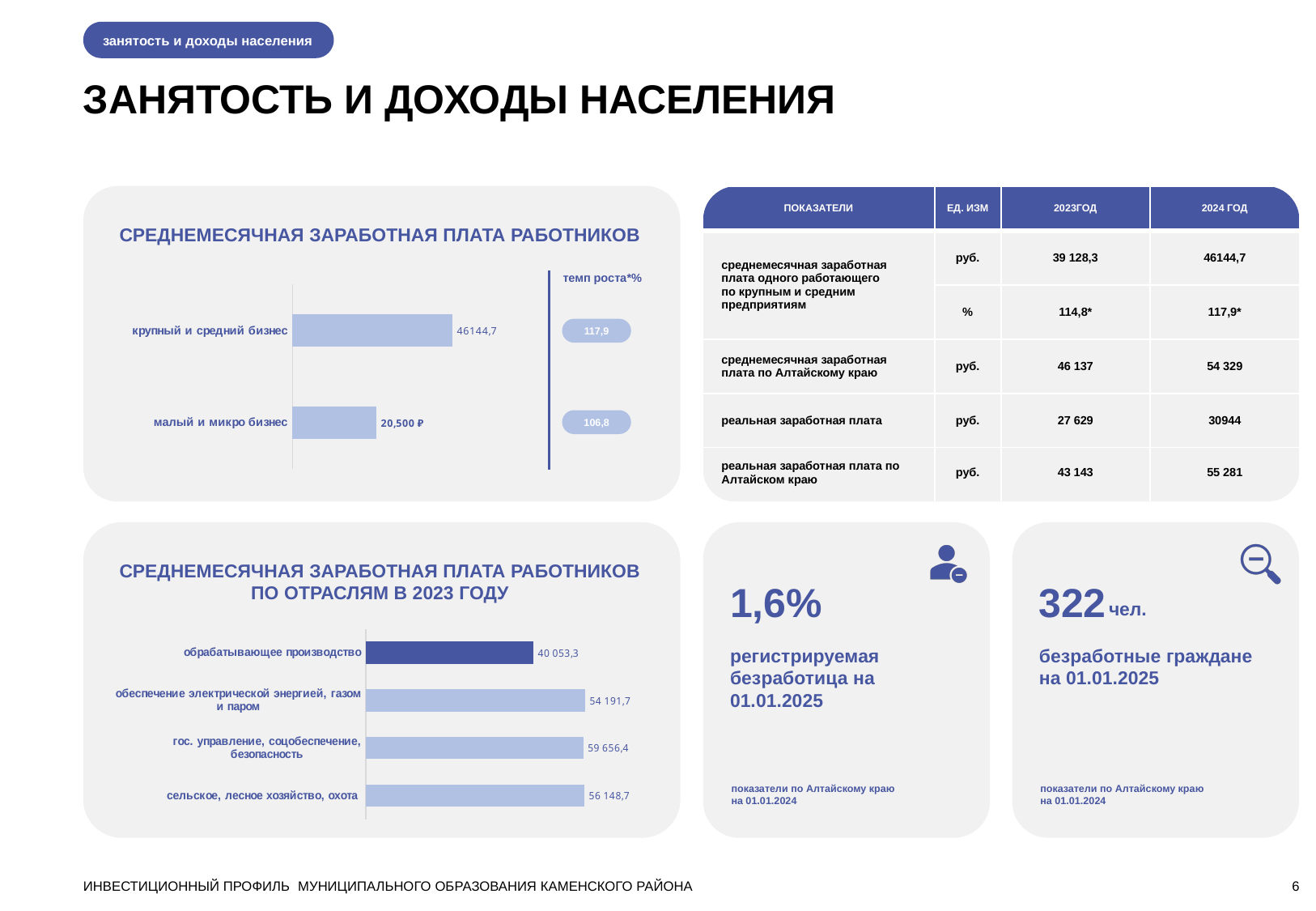
In the chart 'СРЕДНЕМЕСЯЧНАЯ ЗАРАБОТНАЯ ПЛАТА РАБОТНИКОВ' (top left), how many categories are plotted? 2 In the chart 'СРЕДНЕМЕСЯЧНАЯ ЗАРАБОТНАЯ ПЛАТА РАБОТНИКОВ ПО ОТРАСЛЯМ В 2023 ГОДУ' (bottom left), what is the value for 'обрабатывающее производство'? 40 053,3 In the chart 'СРЕДНЕМЕСЯЧНАЯ ЗАРАБОТНАЯ ПЛАТА РАБОТНИКОВ' (top left), what is the 'темп роста*%' shown for 'малый и микро бизнес'? 106,8 In the chart 'СРЕДНЕМЕСЯЧНАЯ ЗАРАБОТНАЯ ПЛАТА РАБОТНИКОВ' (top left), what is the value for 'крупный и средний бизнес'? 46144,7 In the chart 'СРЕДНЕМЕСЯЧНАЯ ЗАРАБОТНАЯ ПЛАТА РАБОТНИКОВ ПО ОТРАСЛЯМ В 2023 ГОДУ' (bottom left), which category has the highest value? гос. управление, соцобеспечение, безопасность In the chart 'СРЕДНЕМЕСЯЧНАЯ ЗАРАБОТНАЯ ПЛАТА РАБОТНИКОВ ПО ОТРАСЛЯМ В 2023 ГОДУ' (bottom left), which category has the lowest value? обрабатывающее производство In the chart 'СРЕДНЕМЕСЯЧНАЯ ЗАРАБОТНАЯ ПЛАТА РАБОТНИКОВ ПО ОТРАСЛЯМ В 2023 ГОДУ' (bottom left), which is larger: 'обеспечение электрической энергией, газом и паром' or 'сельское, лесное хозяйство, охота'? сельское, лесное хозяйство, охота In the chart 'СРЕДНЕМЕСЯЧНАЯ ЗАРАБОТНАЯ ПЛАТА РАБОТНИКОВ' (top left), what is the value for 'малый и микро бизнес'? 20,500 ₽ In the chart 'СРЕДНЕМЕСЯЧНАЯ ЗАРАБОТНАЯ ПЛАТА РАБОТНИКОВ' (top left), which category has the higher value? крупный и средний бизнес In the chart 'СРЕДНЕМЕСЯЧНАЯ ЗАРАБОТНАЯ ПЛАТА РАБОТНИКОВ ПО ОТРАСЛЯМ В 2023 ГОДУ' (bottom left), how many categories are plotted? 4 What kind of chart is 'СРЕДНЕМЕСЯЧНАЯ ЗАРАБОТНАЯ ПЛАТА РАБОТНИКОВ ПО ОТРАСЛЯМ В 2023 ГОДУ' (bottom left)? bar chart In the chart 'СРЕДНЕМЕСЯЧНАЯ ЗАРАБОТНАЯ ПЛАТА РАБОТНИКОВ ПО ОТРАСЛЯМ В 2023 ГОДУ' (bottom left), what is the value for 'сельское, лесное хозяйство, охота'? 56 148,7